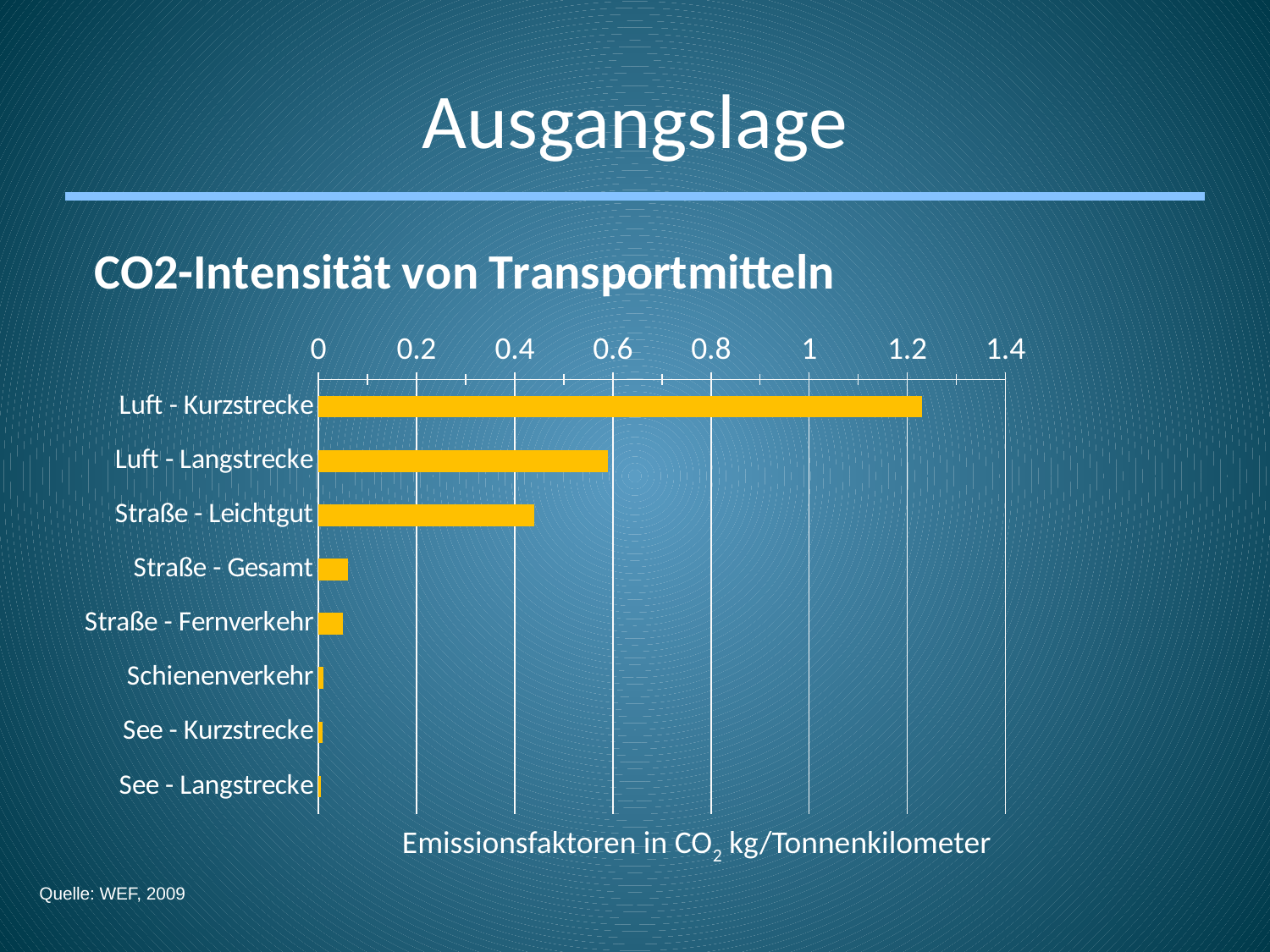
Is the value for Luft - Langstrecke greater or less than 0.8? less Which has a larger value, Luft - Langstrecke or Straße - Leichtgut? Luft - Langstrecke What kind of chart is shown on the slide? bar chart What is the label of the value axis of the chart? Emissionsfaktoren in CO2 kg/Tonnenkilometer Is the value for Straße - Leichtgut greater or less than 0.4? greater How many transport categories are plotted in the chart? 8 Is the value for Luft - Kurzstrecke greater or less than 1.2? greater What is the title of the chart? CO2-Intensität von Transportmitteln Which transport category has the highest CO2 intensity in the chart? Luft - Kurzstrecke Which has a larger value, Straße - Fernverkehr or Luft - Kurzstrecke? Luft - Kurzstrecke Which has a larger value, Schienenverkehr or Straße - Leichtgut? Straße - Leichtgut